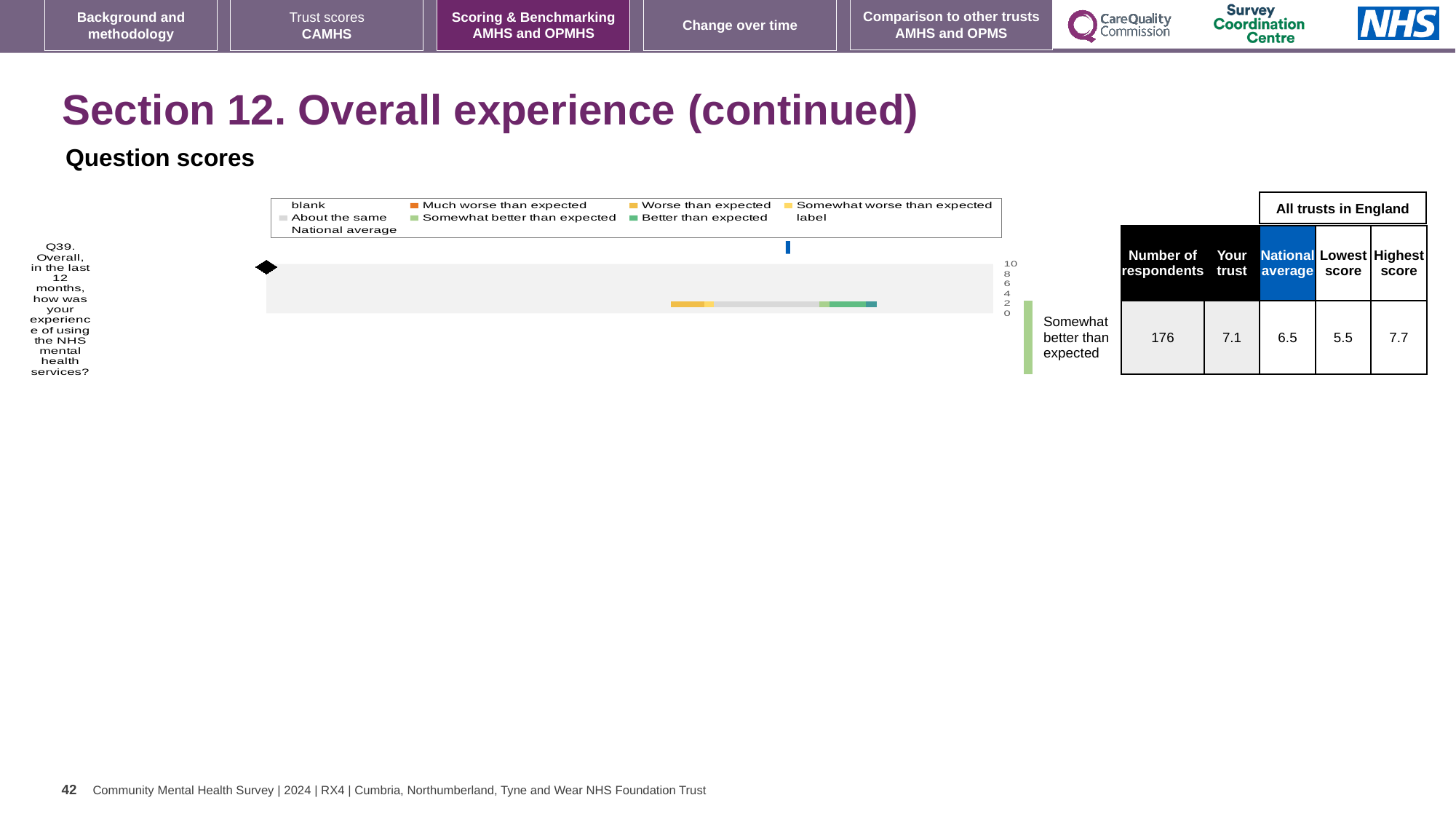
What is the highest tick value shown on the chart's numeric axis? 10 Which question number is plotted in the chart? Q39 In the table beside the chart, how many respondents answered Q39? 176 In the table beside the chart, what is the national average score for Q39? 6.5 In the table beside the chart, what is the difference between the 'Your trust' score and the national average for Q39? 0.6 In the table beside the chart, what is the difference between the highest score and the lowest score for Q39? 2.2 Which legend entry is shown with a teal/green marker: 'Better than expected' or 'Much worse than expected'? Better than expected What benchmark category label is shown next to the chart for Q39? Somewhat better than expected What kind of chart is shown on the slide? Bar chart In the table beside the chart, what is the 'Your trust' score for Q39? 7.1 In the table beside the chart, which is larger for Q39: the 'Your trust' score or the national average? Your trust How many questions (categories) are plotted in the chart? 1